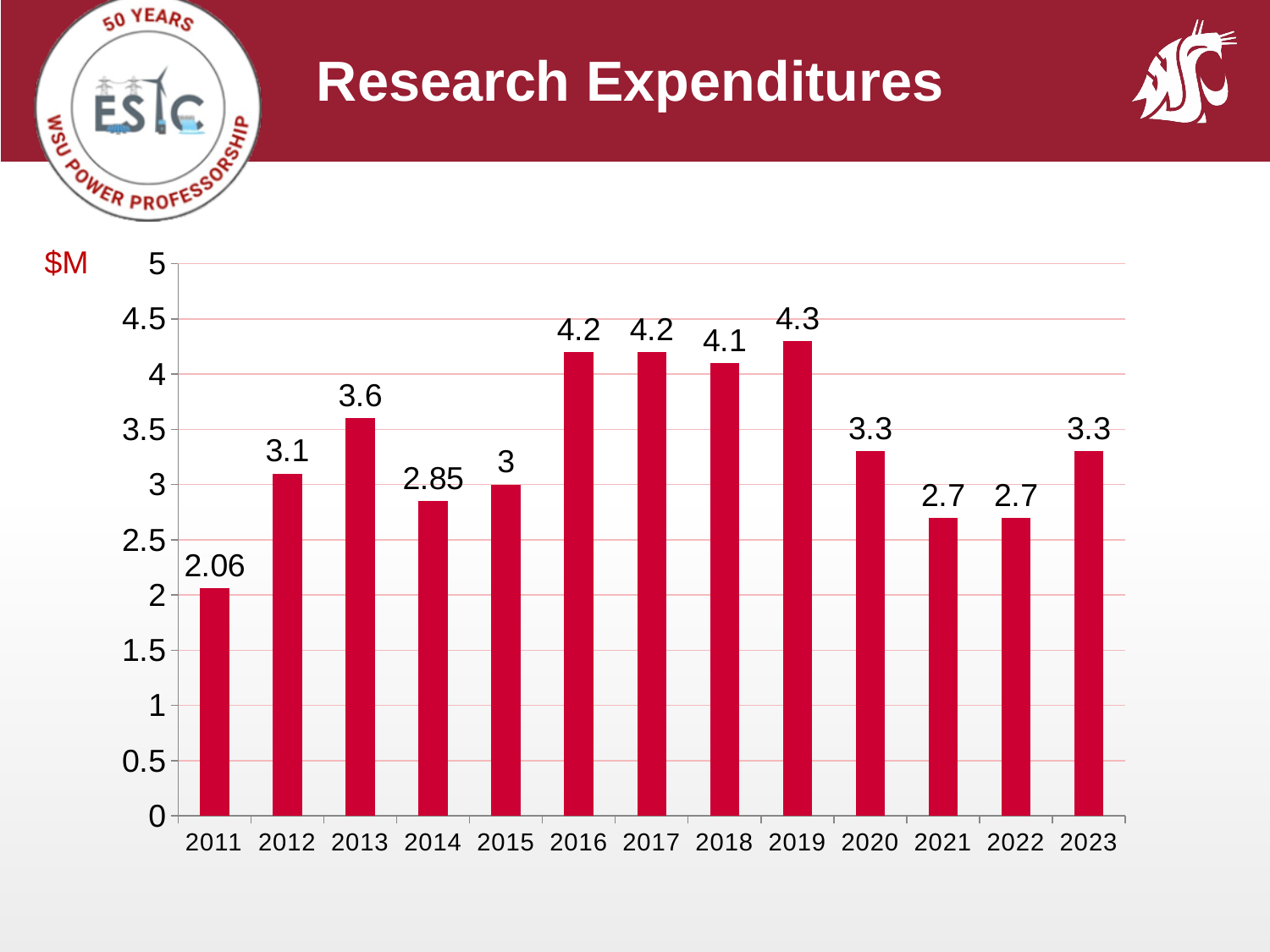
What is the research expenditure value for 2014? 2.85 What kind of chart is shown on the slide? Bar chart What is the research expenditure value for 2019? 4.3 How many years are shown on the x axis of the chart? 13 Do the research expenditure values rise or fall from 2019 to 2021? Fall Which year has the lowest research expenditure? 2011 Which year has the highest research expenditure? 2019 What unit label is shown at the top of the y axis? $M What is the research expenditure value for 2011? 2.06 What is the difference between the research expenditure in 2019 and in 2011? 2.24 What is the difference between the research expenditure in 2013 and in 2014? 0.75 Which year has a larger research expenditure, 2013 or 2020? 2013